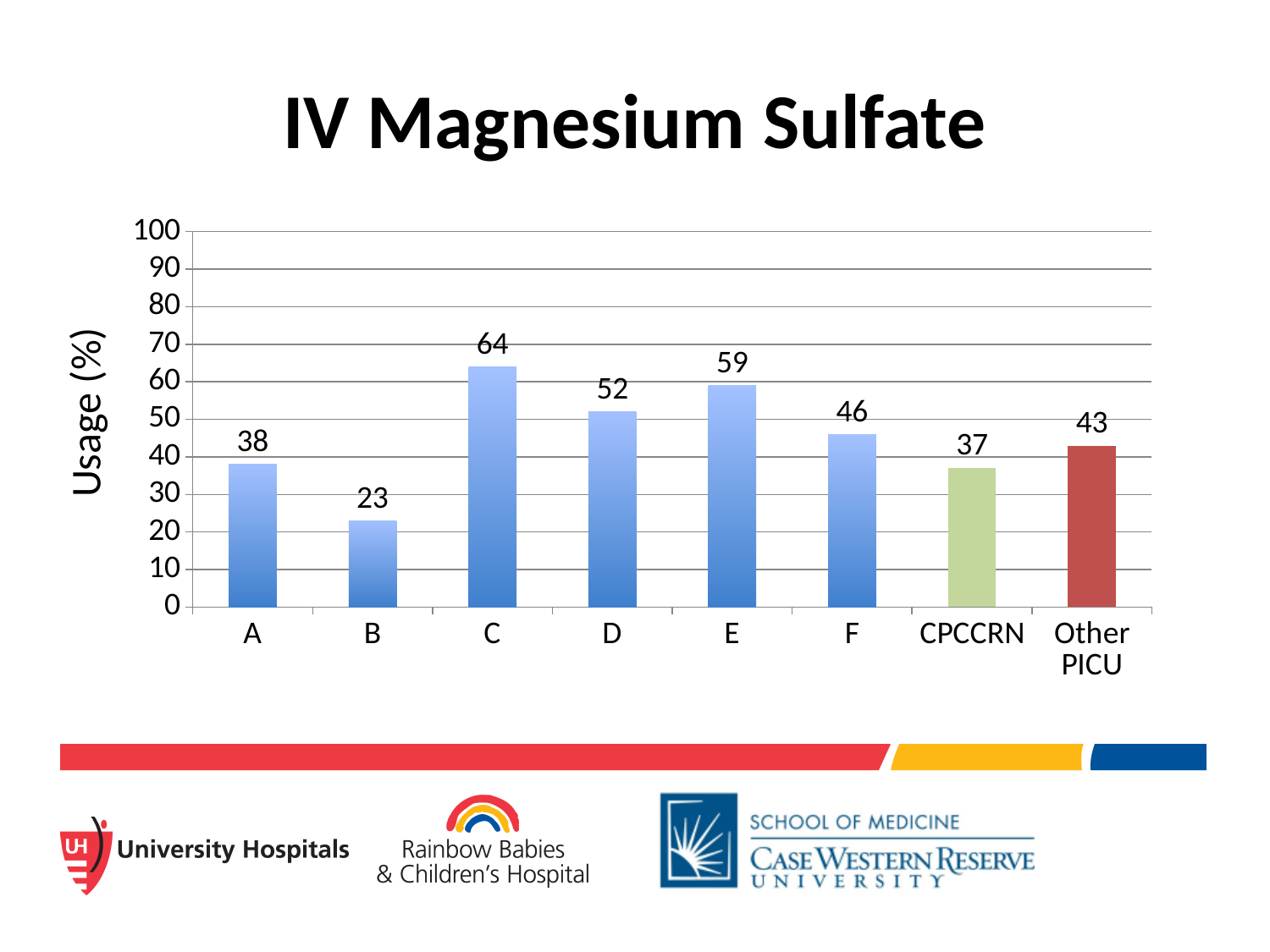
How many categories are shown on the x axis? 8 Which has higher usage, site F or site A? F What is the title of the chart? IV Magnesium Sulfate What kind of chart is shown? bar chart Is the usage for site B greater or less than 30? less Which category has the highest usage? C What is the usage (%) for site C? 64 What is the usage (%) for CPCCRN? 37 What is the difference in usage between site E and site D? 7 What is the usage (%) for Other PICU? 43 What is the difference in usage between Other PICU and CPCCRN? 6 Which category has the lowest usage? B